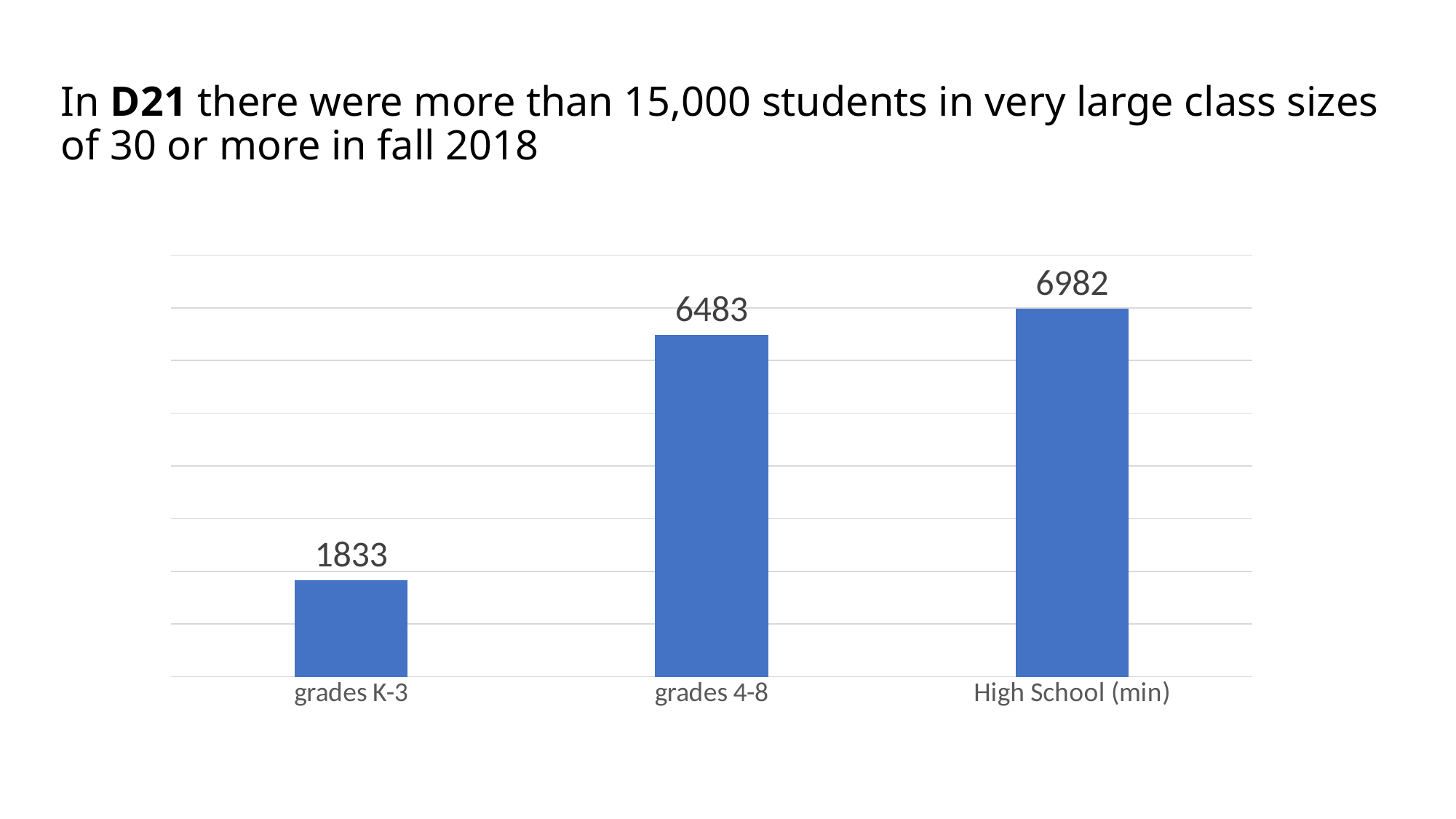
What is the value for grades K-3? 1833 What is the difference between the values for grades 4-8 and grades K-3? 4650 What is the value for grades 4-8? 6483 Which is larger, the value for grades K-3 or the value for grades 4-8? grades 4-8 What is the value for High School (min)? 6982 What kind of chart is shown on the slide? bar chart What colour are the bars in the chart? blue Which category has the lowest value? grades K-3 Do the values rise or fall from left to right across the categories? rise What is the difference between the values for High School (min) and grades 4-8? 499 How many categories are shown on the chart? 3 Which category has the highest value? High School (min)